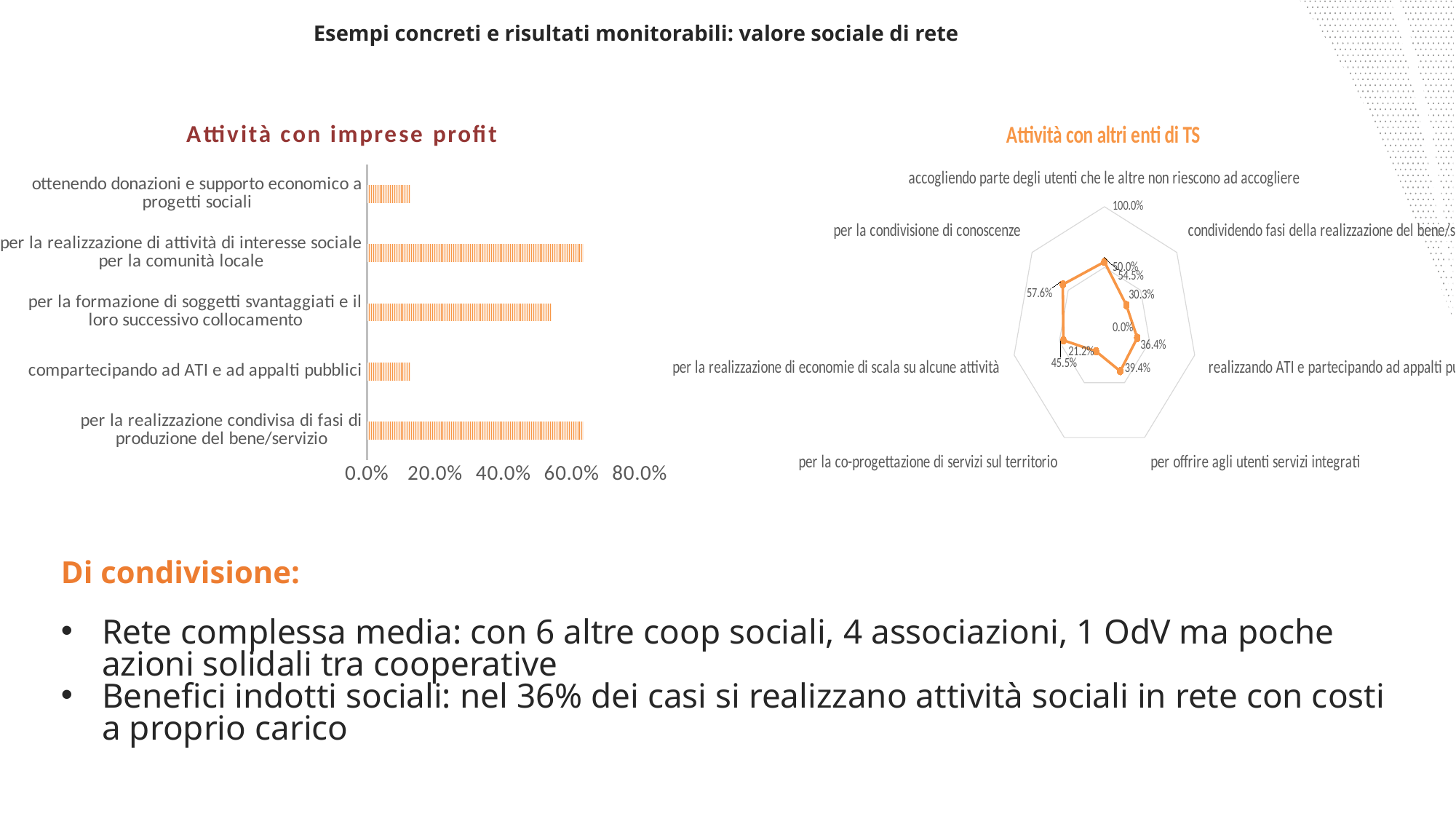
In the 'Attività con imprese profit' chart, is the value for 'compartecipando ad ATI e ad appalti pubblici' greater or less than 20.0%? less What is the title of the radar chart on the right of the slide? Attività con altri enti di TS In the 'Attività con imprese profit' chart, is the value for 'ottenendo donazioni e supporto economico a progetti sociali' greater or less than 20.0%? less In the 'Attività con imprese profit' chart, which is larger: 'per la realizzazione di attività di interesse sociale per la comunità locale' or 'per la formazione di soggetti svantaggiati e il loro successivo collocamento'? per la realizzazione di attività di interesse sociale per la comunità locale In the 'Attività con imprese profit' chart, is the value for 'per la formazione di soggetti svantaggiati e il loro successivo collocamento' greater or less than 40.0%? greater What type of chart is 'Attività con altri enti di TS'? radar chart In the 'Attività con imprese profit' chart, which is larger: 'per la formazione di soggetti svantaggiati e il loro successivo collocamento' or 'compartecipando ad ATI e ad appalti pubblici'? per la formazione di soggetti svantaggiati e il loro successivo collocamento What is the maximum value shown on the x axis of the 'Attività con imprese profit' chart? 80.0% How many categories does the 'Attività con imprese profit' chart show? 5 What type of chart is 'Attività con imprese profit'? bar chart